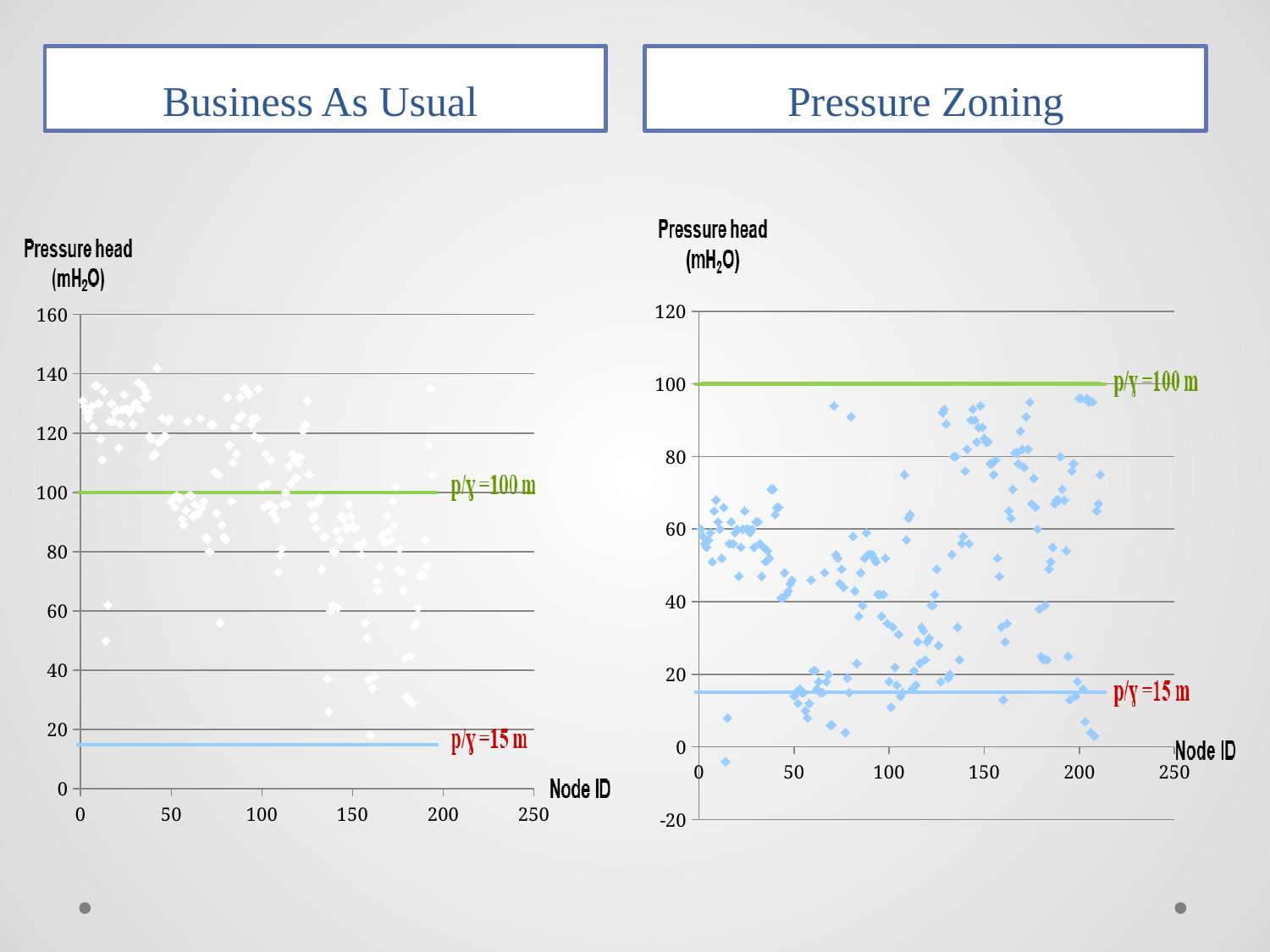
In the Business As Usual chart, what pressure head value does the blue horizontal line mark? 15 m In the Pressure Zoning chart, what pressure head value does the blue horizontal line mark? 15 m What kind of chart is the Pressure Zoning chart? scatter chart Which chart has the higher top value on its vertical axis, Business As Usual or Pressure Zoning? Business As Usual What is the label of the horizontal axis in the Pressure Zoning chart? Node ID What is the highest tick value on the vertical axis of the Business As Usual chart? 160 In the Pressure Zoning chart, what pressure head value does the green horizontal line mark? 100 m How many horizontal reference lines are drawn on the Pressure Zoning chart? 2 What kind of chart is the Business As Usual chart? scatter chart In the Business As Usual chart, what pressure head value does the green horizontal line mark? 100 m What is the highest tick value on the vertical axis of the Pressure Zoning chart? 120 In the Business As Usual chart, what is the difference between the two reference line values (p/γ = 100 m and p/γ = 15 m)? 85 m